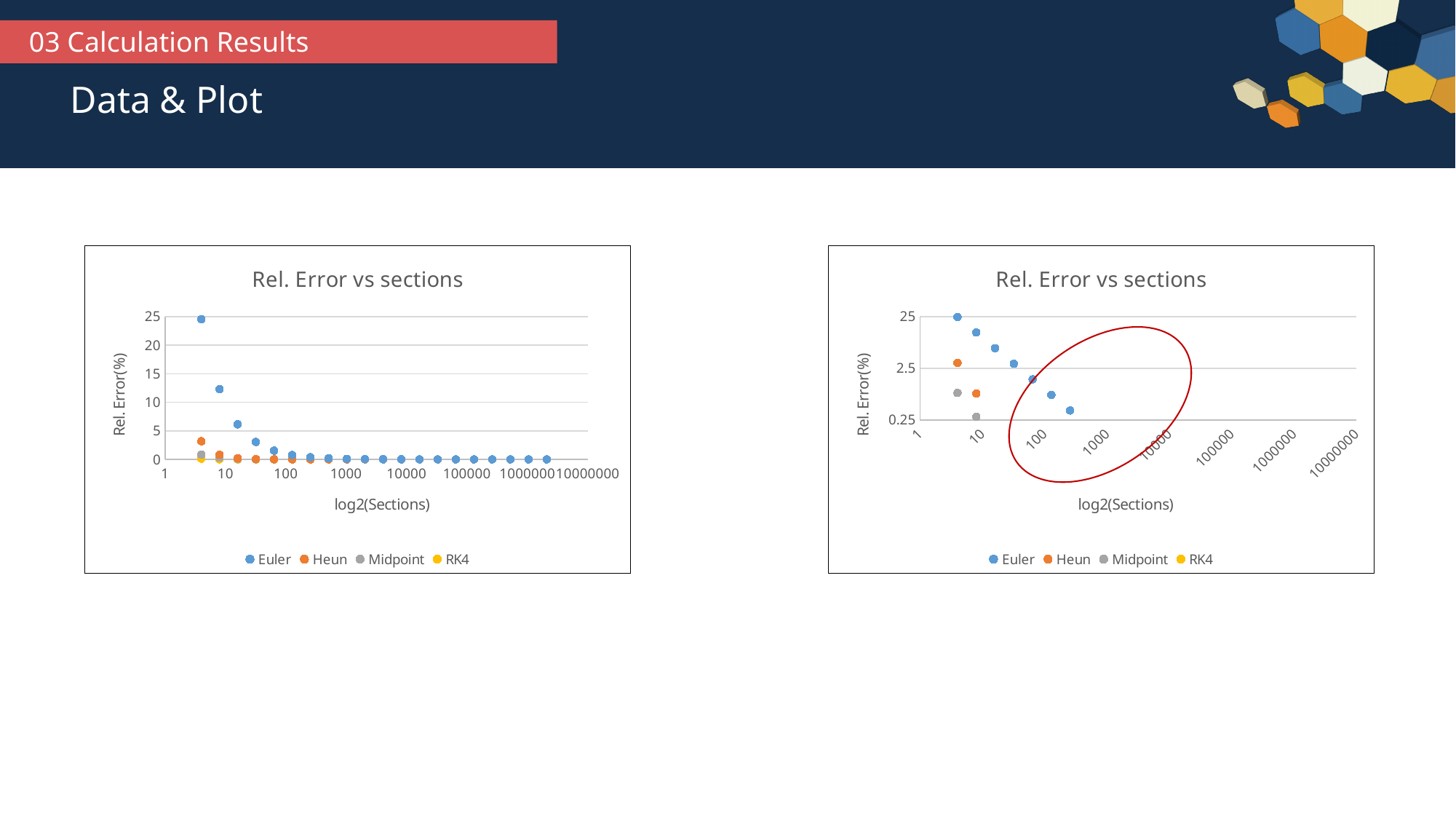
How many series does the legend of the left chart list? 4 In the left chart, is the first Euler value (at the smallest number of sections) greater or less than 20? greater In the right chart, which series has the highest relative error at the smallest number of sections? Euler What is the x-axis title of the left chart? log2(Sections) In the left chart, does the Euler relative error rise or fall as the number of sections increases? fall In the right chart, is the first Midpoint value (at the smallest number of sections) greater or less than 2.5? less What kind of chart is the left chart? scatter chart In the left chart, is the second Euler value (at about 8 sections) greater or less than 10? greater In the left chart, at the smallest number of sections, which series has the larger relative error, Euler or Heun? Euler What is the title of the right chart? Rel. Error vs sections